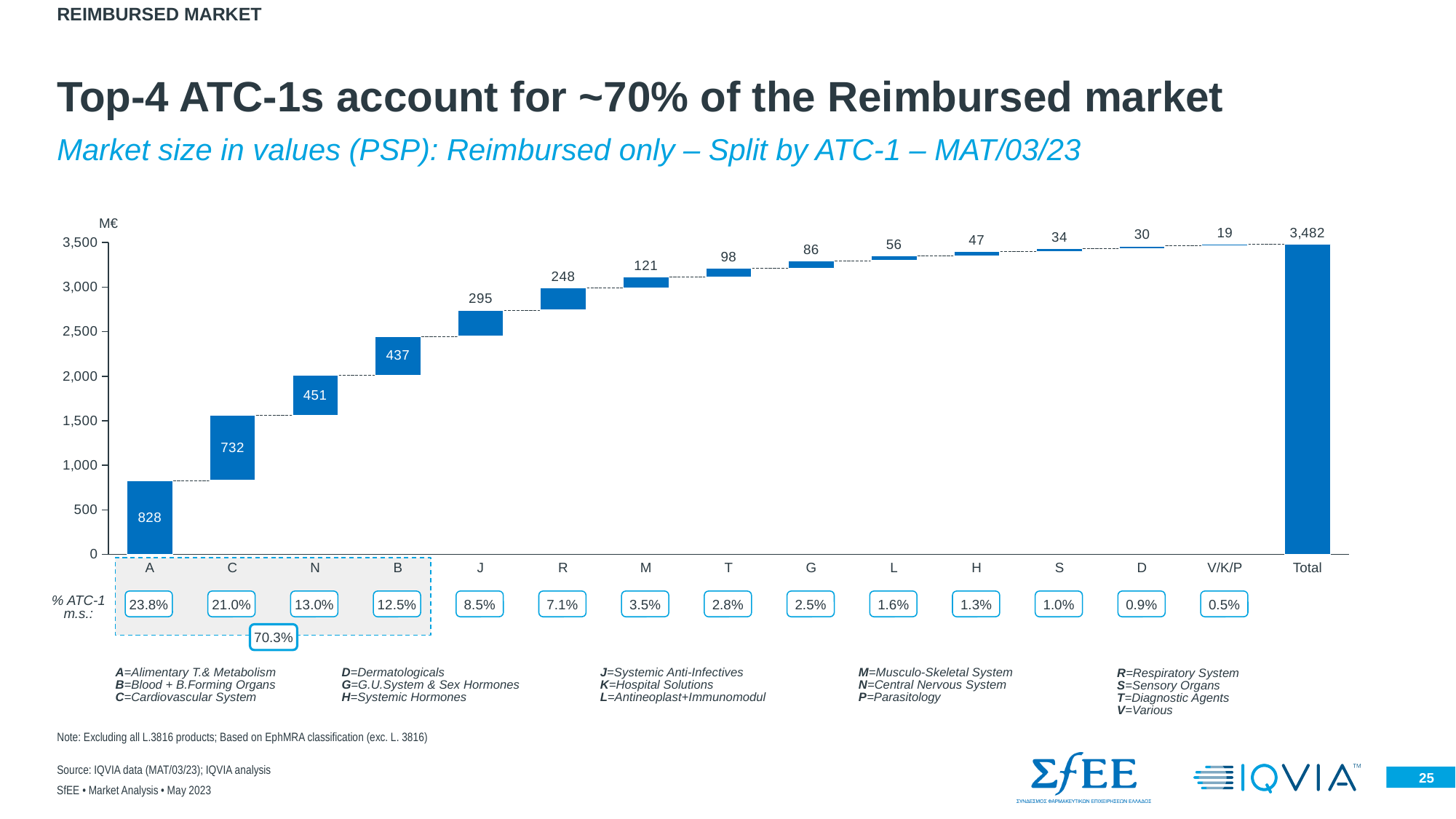
Which ATC-1 category has the lowest value in the chart? V/K/P What combined market share is shown for the top-4 ATC-1 categories (A, C, N, B)? 70.3% What market share percentage is shown for category B? 12.5% What is the value for ATC-1 category N in the chart? 451 Excluding the Total bar, which ATC-1 category has the highest value? A What is the value for ATC-1 category A in the chart? 828 What is the value for ATC-1 category V/K/P in the chart? 19 What is the value of the Total bar in the chart? 3,482 What kind of chart is shown on the slide? bar chart What is the difference between the values for categories A and C? 96 How many ATC-1 categories are shown on the x axis, excluding the Total bar? 14 Which has a larger value, category J or category R? J